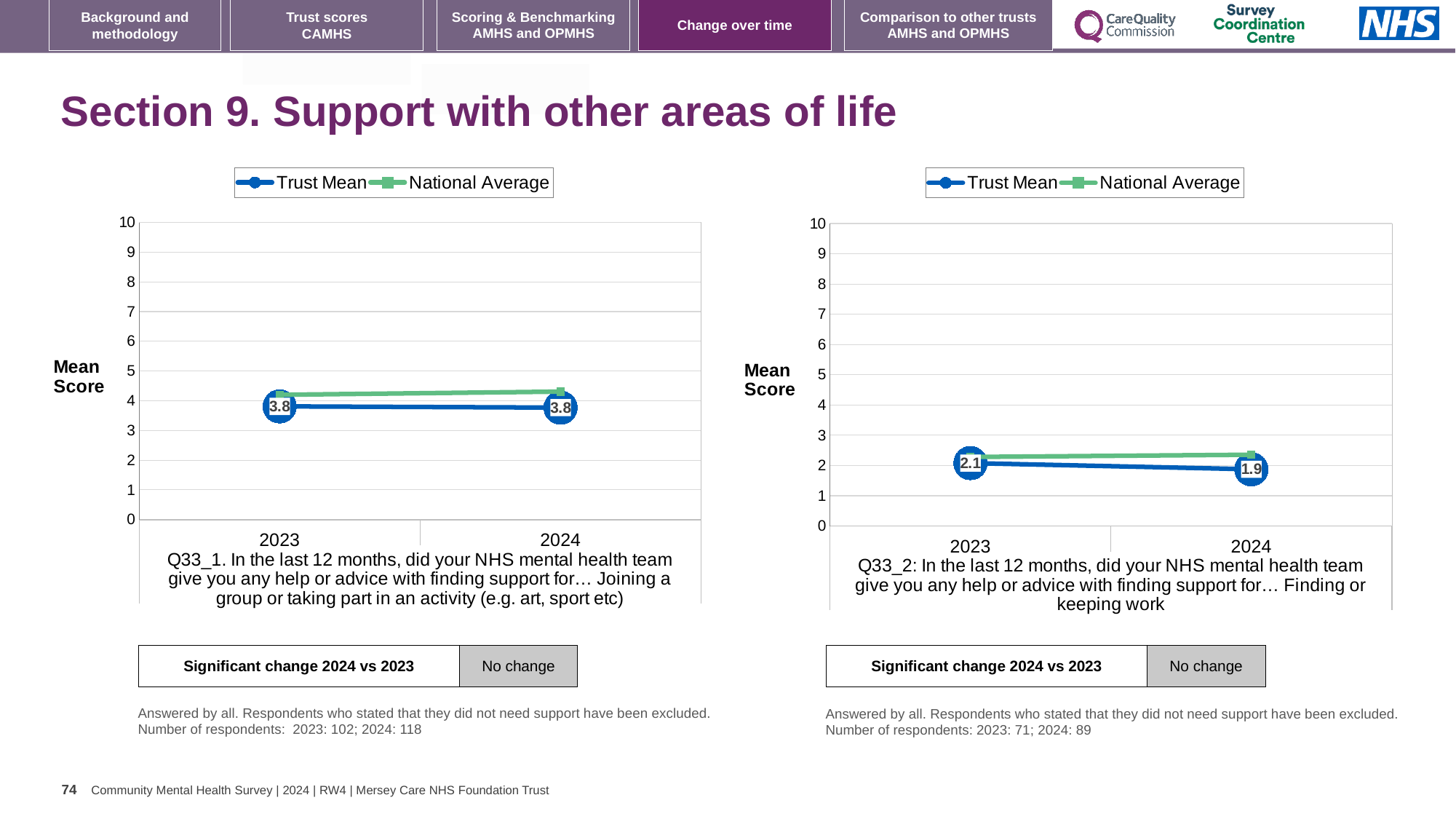
On the left chart (Q33_1), what is the Trust Mean score for 2024? 3.8 On the right chart (Q33_2), what is the Trust Mean score for 2024? 1.9 How many years are plotted on the x axis of the right chart (Q33_2)? 2 On the left chart (Q33_1), is the National Average value for 2024 greater or less than 5? less How many series does the legend of the left chart (Q33_1) list? 2 On the right chart (Q33_2), what is the Trust Mean score for 2023? 2.1 On the right chart (Q33_2), does the Trust Mean rise or fall from 2023 to 2024? fall What kind of chart is the left chart (Q33_1)? line chart On the right chart (Q33_2), is the National Average value for 2024 greater or less than 2? greater On the right chart (Q33_2), what is the difference between the Trust Mean scores for 2023 and 2024? 0.2 On the left chart (Q33_1), what is the Trust Mean score for 2023? 3.8 On the right chart (Q33_2), which year has the higher Trust Mean score, 2023 or 2024? 2023